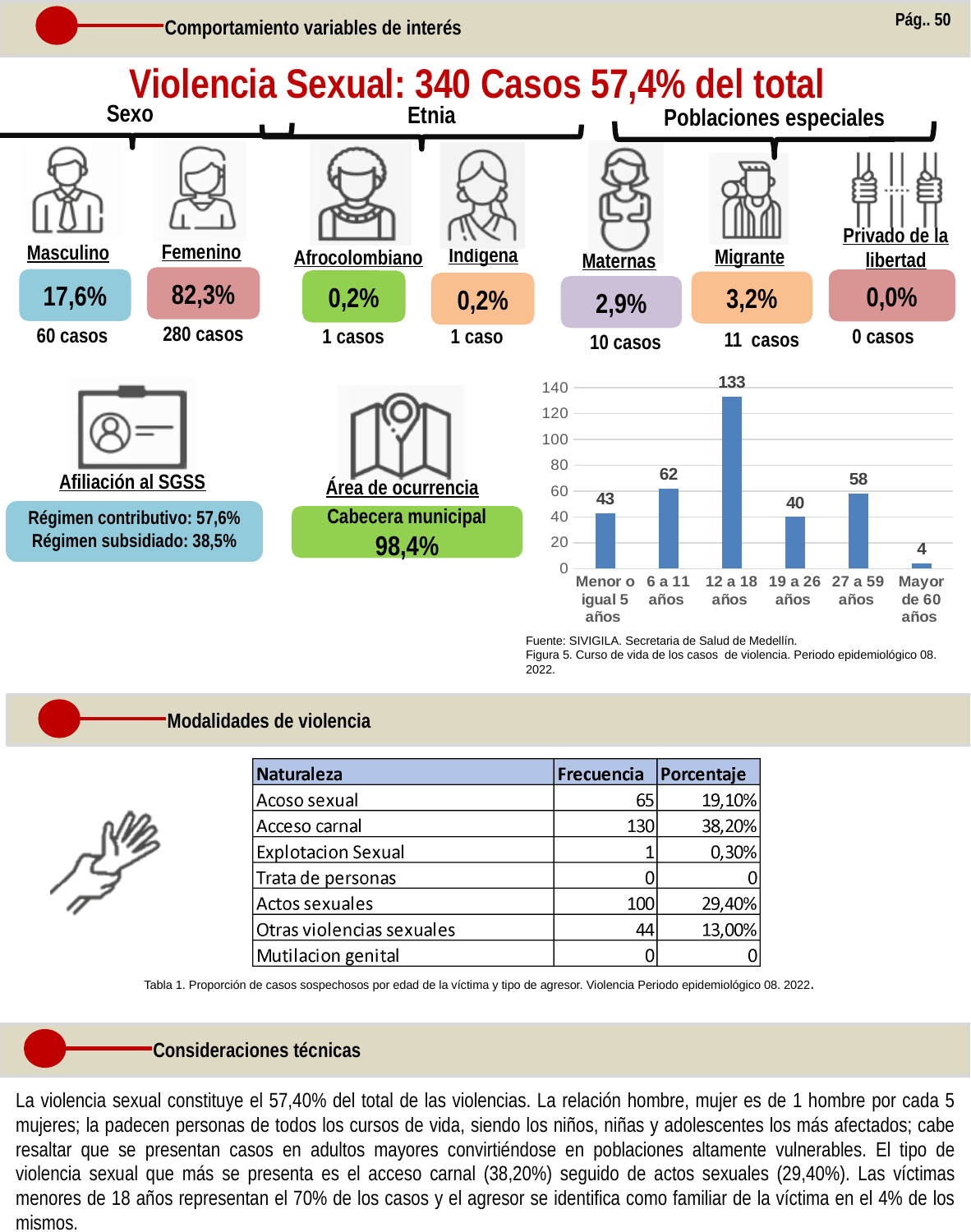
In the age-group bar chart, what is the value for 'Mayor de 60 años'? 4 How many age-group categories are shown in the bar chart? 6 What type of chart is shown in Figura 5 (the age-group chart)? bar chart In the age-group bar chart, what is the value for '12 a 18 años'? 133 Which age group has the lowest value in the bar chart? Mayor de 60 años In the age-group bar chart, is the value for '12 a 18 años' greater or less than 120? greater Which age group has the highest value in the bar chart? 12 a 18 años In the age-group bar chart, what is the value for 'Menor o igual 5 años'? 43 In the age-group bar chart, what is the value for '27 a 59 años'? 58 In the age-group bar chart, what is the difference between the values for '12 a 18 años' and '6 a 11 años'? 71 In the age-group bar chart, which is larger: the value for '6 a 11 años' or the value for '19 a 26 años'? 6 a 11 años In the age-group bar chart, what is the difference between the values for '27 a 59 años' and '19 a 26 años'? 18